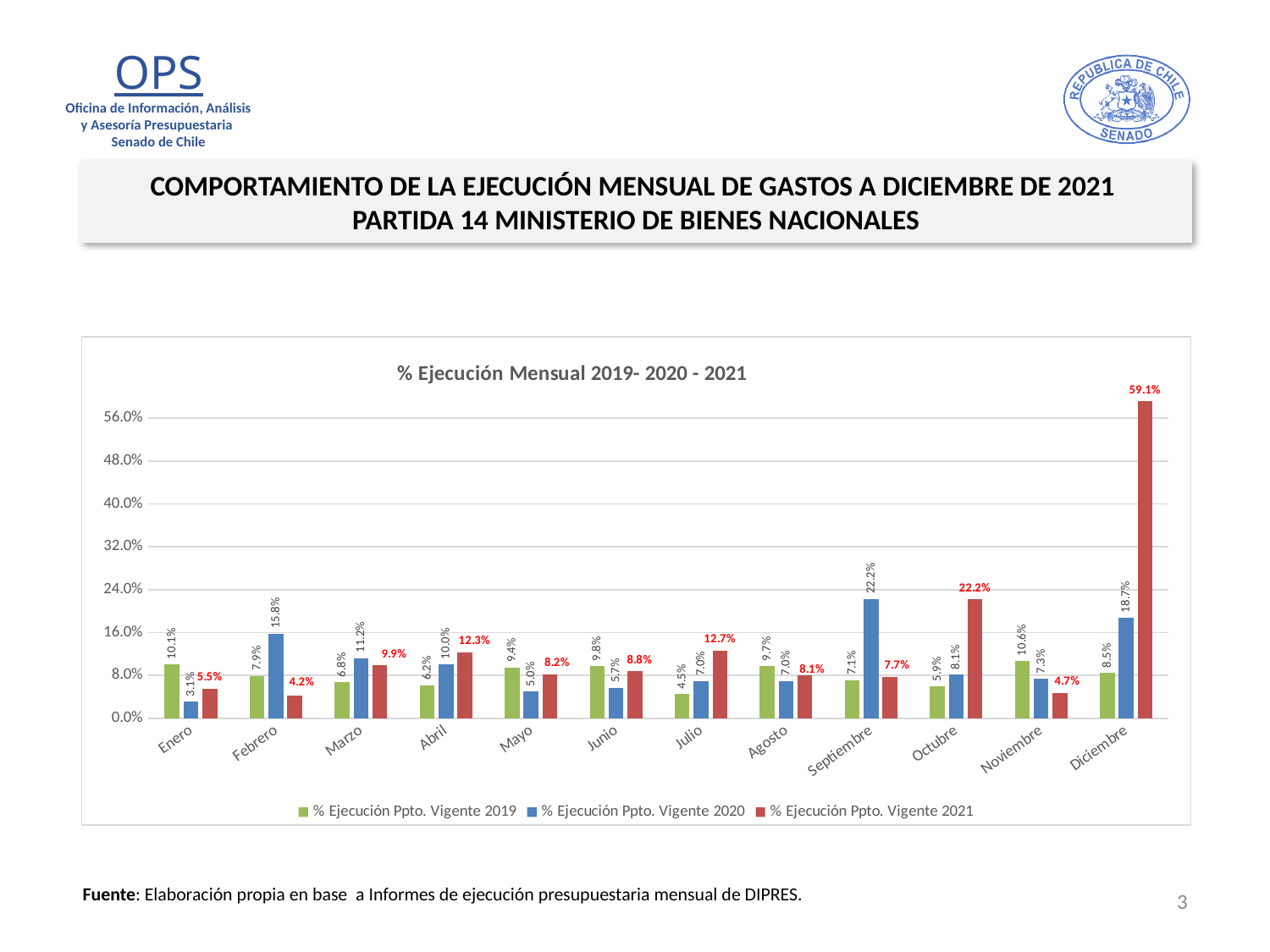
What is the value for % Ejecución Ppto. Vigente 2020 in Septiembre? 22.2% What is the value for % Ejecución Ppto. Vigente 2021 in Julio? 12.7% Is the value for % Ejecución Ppto. Vigente 2021 in Octubre greater or less than 16.0%? greater What is the value for % Ejecución Ppto. Vigente 2021 in Diciembre? 59.1% How many series does the legend list? 3 In Febrero, which series has the larger value: % Ejecución Ppto. Vigente 2020 or % Ejecución Ppto. Vigente 2021? % Ejecución Ppto. Vigente 2020 Which month has the lowest value for % Ejecución Ppto. Vigente 2020? Enero What is the difference between the 2021 and 2020 values in Diciembre? 40.4% What is the value for % Ejecución Ppto. Vigente 2019 in Enero? 10.1% How many months are shown on the x axis? 12 Which month has the highest value for % Ejecución Ppto. Vigente 2021? Diciembre What kind of chart is shown on the slide? Bar chart